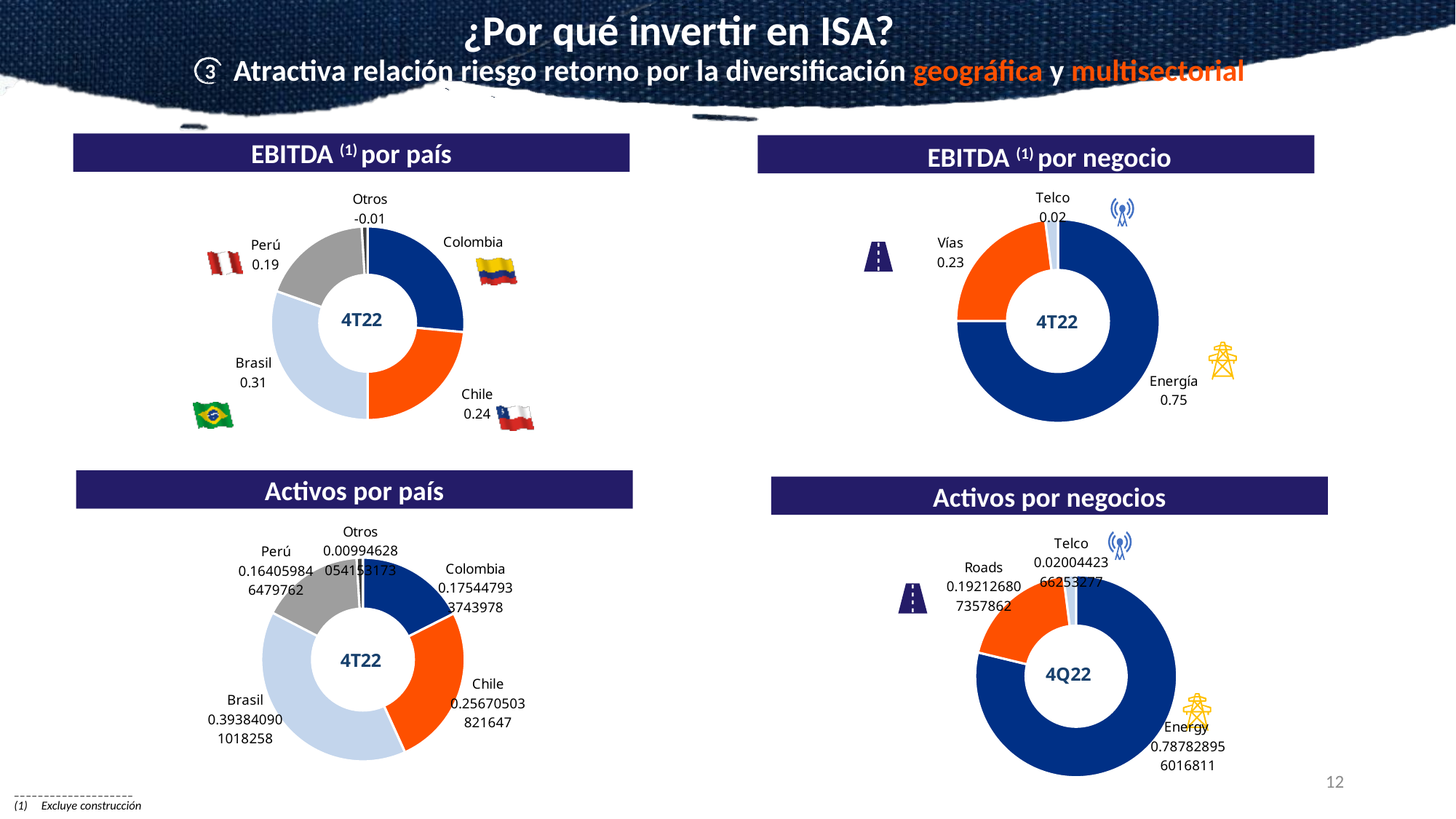
In the 'EBITDA por país' chart, what is the difference between the values for Brasil and Chile? 0.07 In the 'EBITDA por negocio' chart, what is the value for Vías? 0.23 What kind of chart is used for 'Activos por negocios'? doughnut chart In the 'EBITDA por país' chart, what is the value for Perú? 0.19 In the 'EBITDA por país' chart, what is the value for Chile? 0.24 In the 'EBITDA por negocio' chart, what is the value for Energía? 0.75 In the 'EBITDA por negocio' chart, what is the difference between Energía and Vías? 0.52 How many categories are shown in the 'EBITDA por país' chart? 5 In the 'Activos por país' chart, which country has the largest share? Brasil In the 'EBITDA por país' chart, what is the value for Brasil? 0.31 In the 'EBITDA por país' chart, which category has the lowest value? Otros In the 'EBITDA por país' chart, which is larger, Chile or Perú? Chile